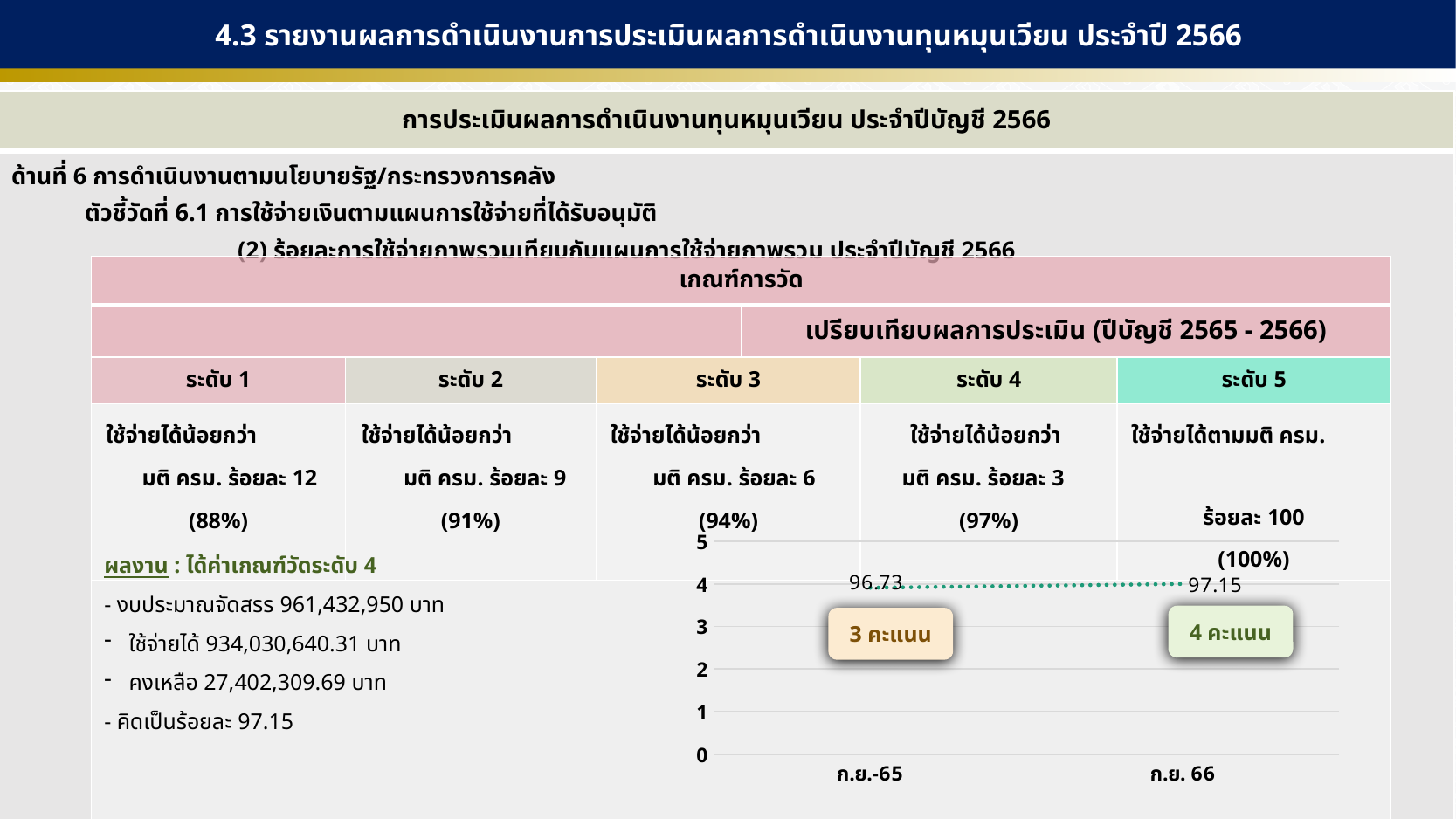
What is the highest value shown on the chart's vertical axis? 5 What score is shown in the callout box for ก.ย. 66? 4 คะแนน What is the data label shown for ก.ย. 66 on the chart? 97.15 What are the two category labels on the chart's horizontal axis? ก.ย.-65 and ก.ย. 66 What is the difference between the labelled values for ก.ย. 66 and ก.ย.-65? 0.42 Do the labelled values rise or fall from ก.ย.-65 to ก.ย. 66? rise Which point on the chart has the higher labelled value, ก.ย.-65 or ก.ย. 66? ก.ย. 66 What is the data label shown for ก.ย.-65 on the chart? 96.73 What score is shown in the callout box for ก.ย.-65? 3 คะแนน What kind of chart is shown on the slide? line chart How many data points are plotted on the chart? 2